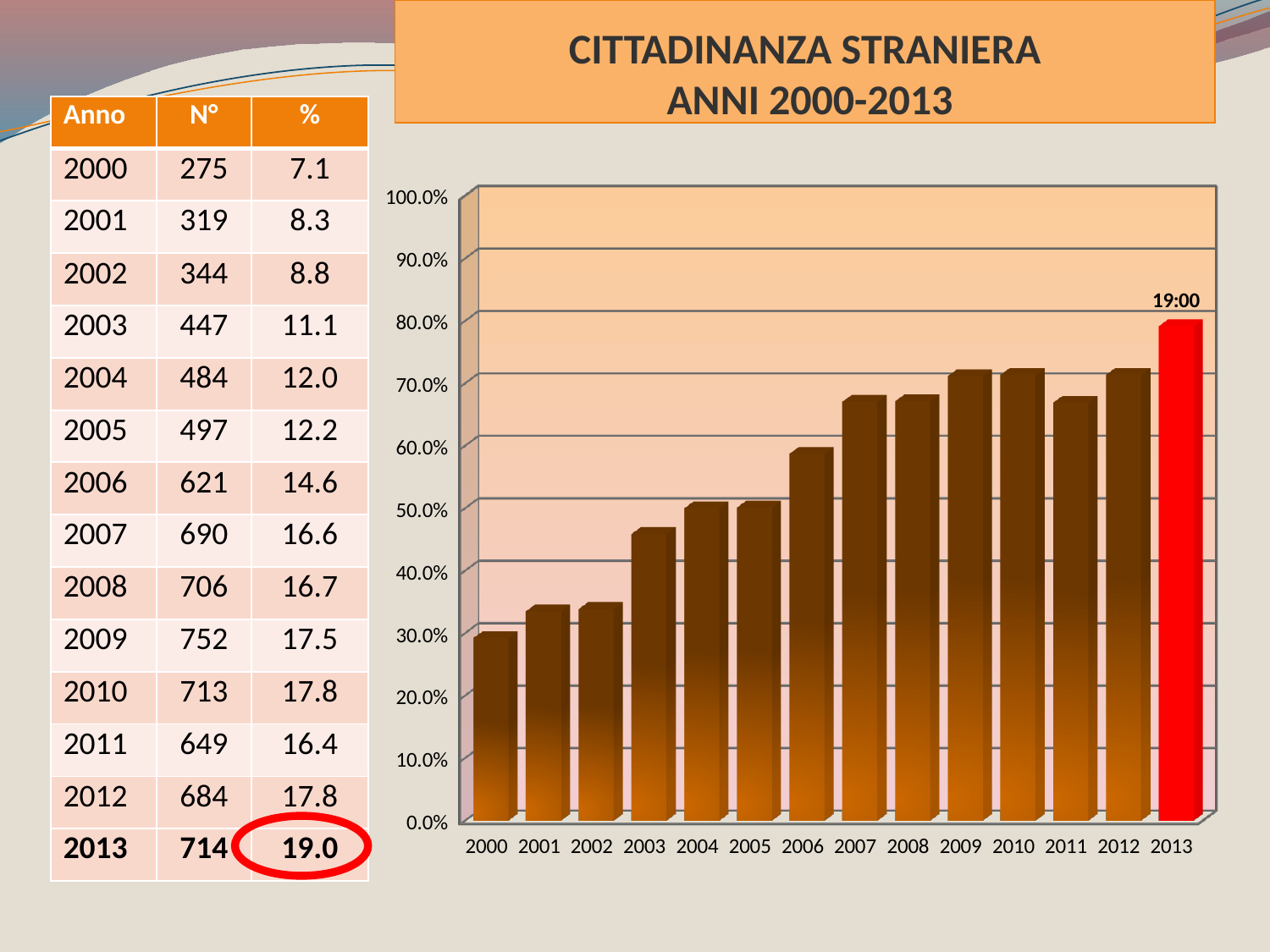
How many years are plotted on the x axis of the chart? 14 Is the bar for 2013 greater or less than 70.0%? greater Which bar is taller, 2007 or 2003? 2007 Is the bar for 2003 greater or less than 50.0%? less Which year has the shortest bar in the chart? 2000 What data label is printed above the bar for 2013? 19:00 Is the bar for 2001 greater or less than 30.0%? greater Which year has the tallest bar in the chart? 2013 Do the bars generally rise or fall from 2000 to 2013? rise What kind of chart is shown on the slide? bar chart What is the title of the chart? CITTADINANZA STRANIERA ANNI 2000-2013